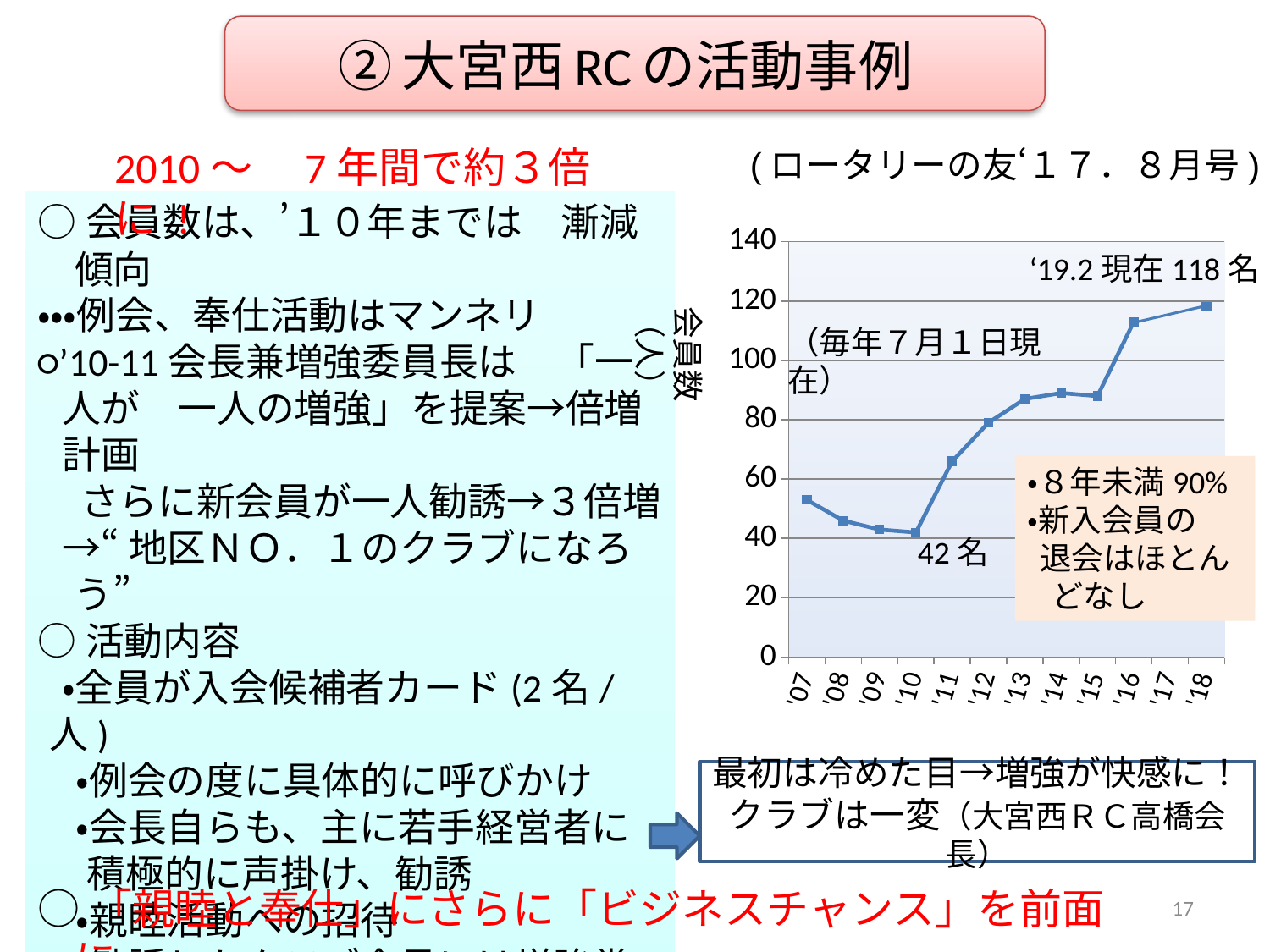
Is the value for '14 greater or less than 100? less Is the value for '07 greater or less than 40? greater Is the value for '16 greater or less than 100? greater Which year on the x axis has the lowest membership value? '10 What is the membership value labelled at '10 on the chart? 42名 Which year on the x axis has the highest membership value? '18 Do the values rise or fall along the x axis from '10 to '18? rise What kind of chart is shown on the slide? line chart Which is larger, the value for '07 or the value for '09? '07 What is the label on the vertical axis of the chart? 会員数